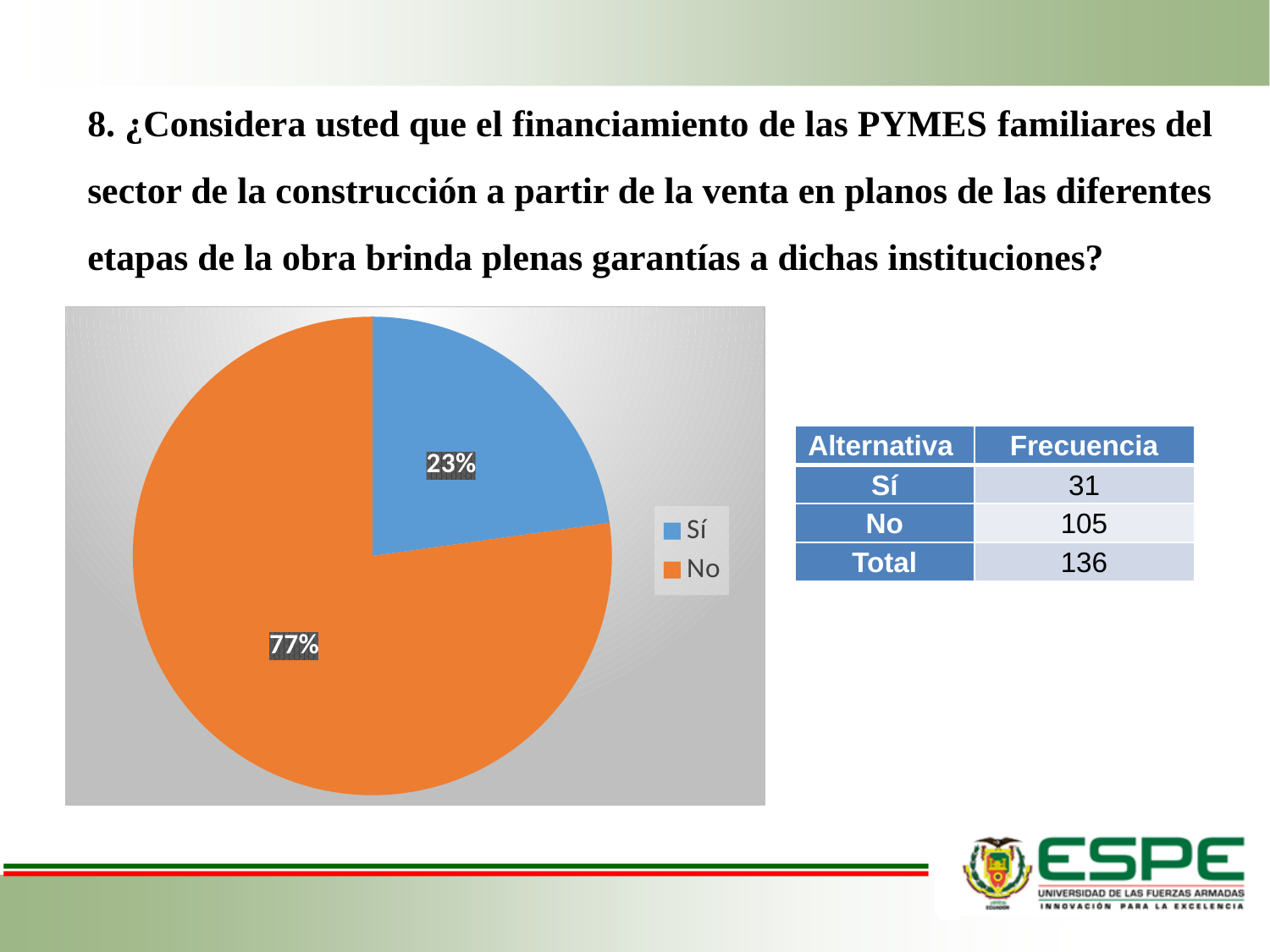
What colour is the "Sí" slice in the pie chart? blue Which category has the smallest share of the pie chart? Sí What is the difference in percentage points between the "No" slice and the "Sí" slice? 54 How many entries does the legend of the pie chart list? 2 What percentage of the pie chart does the "Sí" slice represent? 23% What type of chart is shown on the slide? pie chart What percentage of the pie chart does the "No" slice represent? 77% Which slice is larger, "Sí" or "No"? No How many slices does the pie chart have? 2 Which category has the largest share of the pie chart? No What colour is the "No" slice in the pie chart? orange What is the share of the pie chart taken by the "Sí" slice? 23%